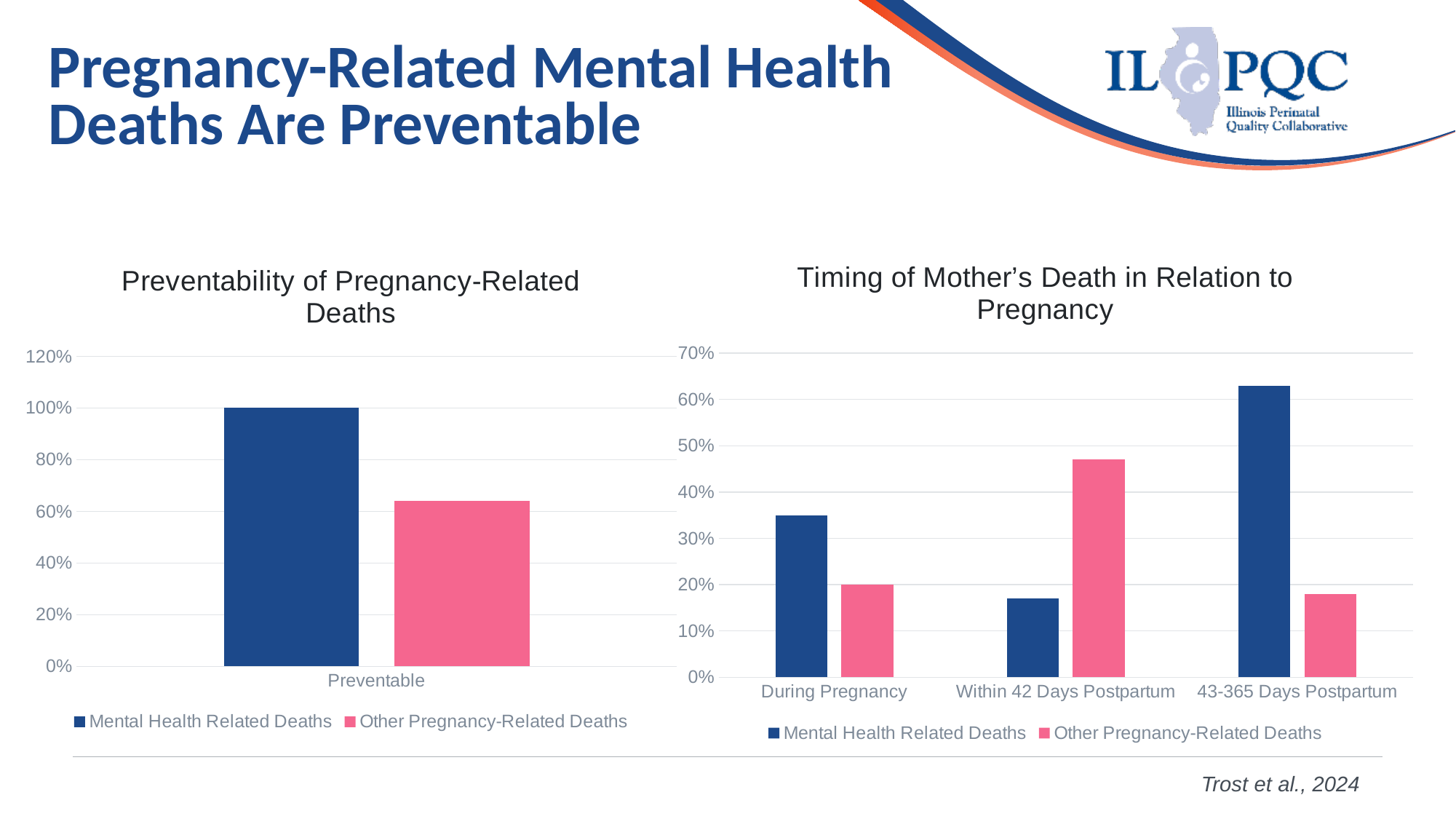
How many series does the legend of the 'Timing of Mother's Death in Relation to Pregnancy' chart list? 2 What kind of chart is the 'Timing of Mother's Death in Relation to Pregnancy' chart? bar chart In the 'Timing of Mother's Death in Relation to Pregnancy' chart, which category has the lowest value for Mental Health Related Deaths? Within 42 Days Postpartum In the 'Preventability of Pregnancy-Related Deaths' chart, which series has the larger value: Mental Health Related Deaths or Other Pregnancy-Related Deaths? Mental Health Related Deaths In the 'Preventability of Pregnancy-Related Deaths' chart, what is the value for Mental Health Related Deaths? 100% How many categories are shown on the x axis of the 'Timing of Mother's Death in Relation to Pregnancy' chart? 3 In the 'Timing of Mother's Death in Relation to Pregnancy' chart, which category has the highest value for Other Pregnancy-Related Deaths? Within 42 Days Postpartum In the 'Timing of Mother's Death in Relation to Pregnancy' chart, is the value for Other Pregnancy-Related Deaths in the Within 42 Days Postpartum category greater or less than 40%? greater In the 'Timing of Mother's Death in Relation to Pregnancy' chart, for the During Pregnancy category, which series has the larger value? Mental Health Related Deaths In the 'Timing of Mother's Death in Relation to Pregnancy' chart, is the value for Mental Health Related Deaths in the 43-365 Days Postpartum category greater or less than 60%? greater In the 'Timing of Mother's Death in Relation to Pregnancy' chart, which category has the highest value for Mental Health Related Deaths? 43-365 Days Postpartum In the 'Preventability of Pregnancy-Related Deaths' chart, is the value for Other Pregnancy-Related Deaths greater or less than 60%? greater